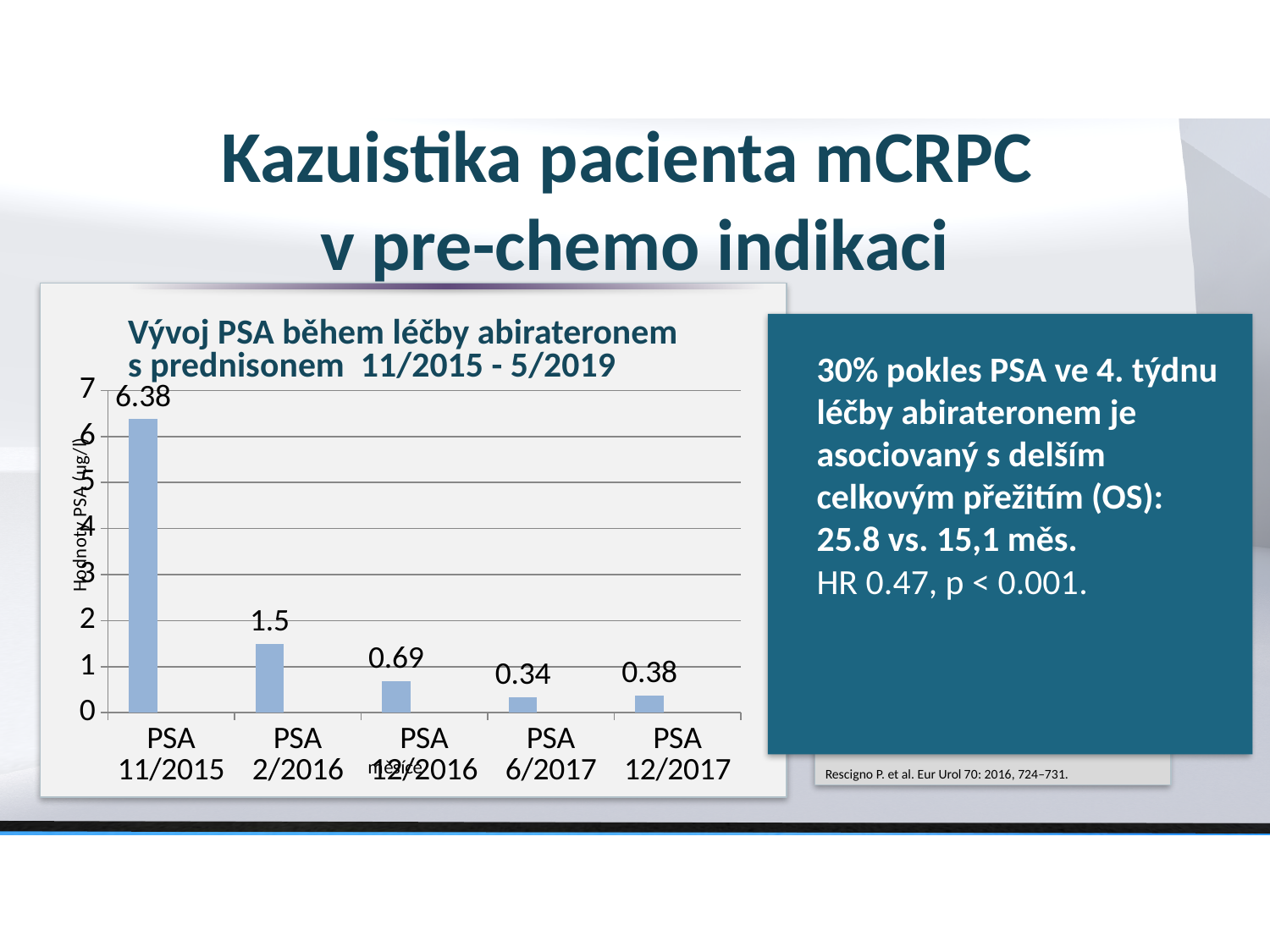
What is the PSA value for PSA 12/2017? 0.38 What is the PSA value for PSA 6/2017? 0.34 What is the PSA value for PSA 12/2016? 0.69 What is the title of the chart? Vývoj PSA během léčby abirateronem s prednisonem 11/2015 - 5/2019 Which category has the lowest PSA value? PSA 6/2017 How many categories are shown on the x axis of the chart? 5 What is the PSA value for PSA 2/2016? 1.5 What kind of chart is shown on the slide? Bar chart What is the difference between the PSA values for PSA 11/2015 and PSA 2/2016? 4.88 What is the PSA value for PSA 11/2015? 6.38 Which is larger, the PSA value for PSA 2/2016 or for PSA 12/2016? PSA 2/2016 Which category has the highest PSA value? PSA 11/2015